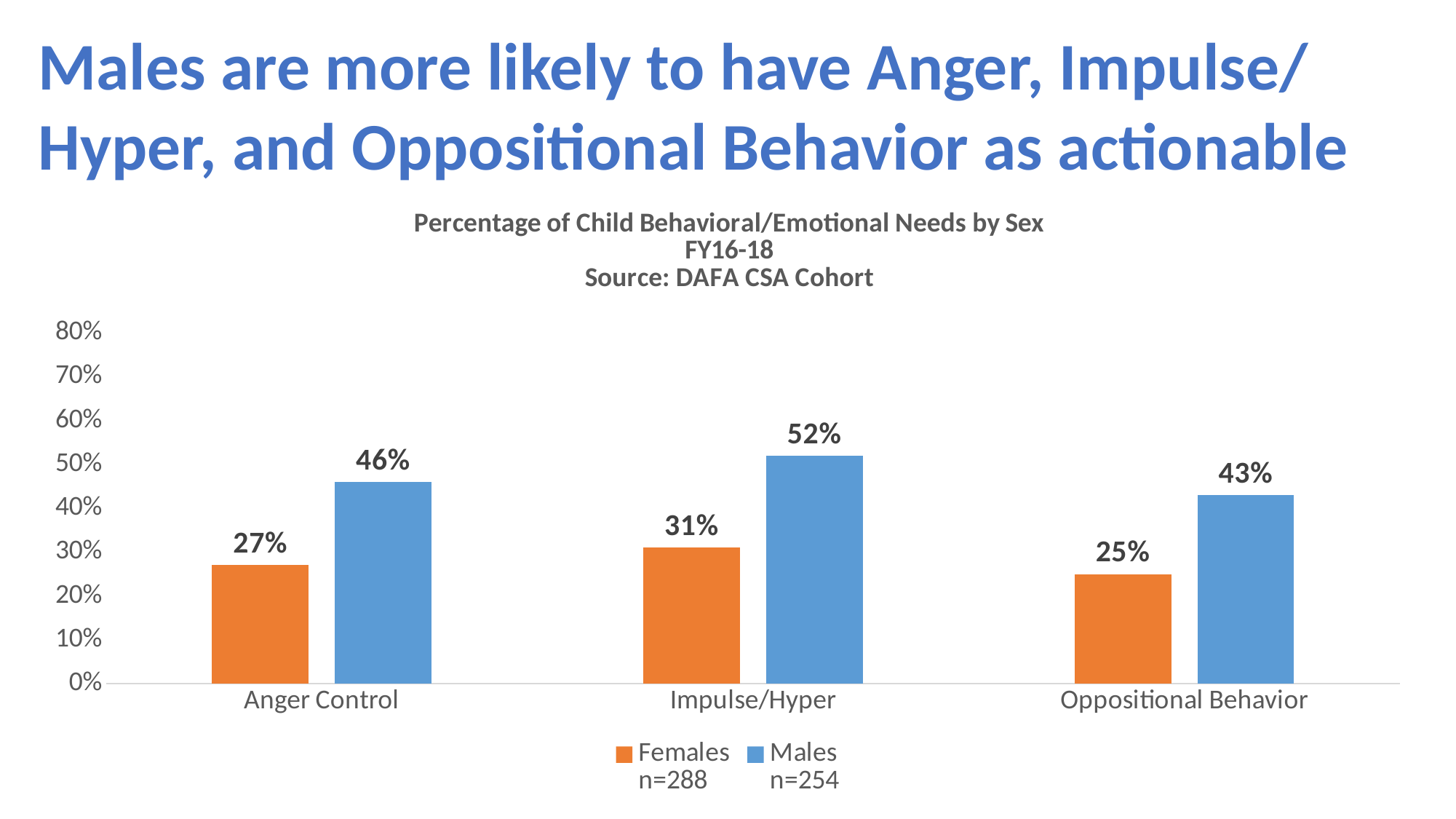
Which is larger: the female value for Impulse/Hyper or the female value for Oppositional Behavior? Impulse/Hyper What is the value for females in the Impulse/Hyper category? 31% What is the value for males in the Oppositional Behavior category? 43% How many categories are shown on the x axis? 3 What is the difference between the male and female values for Anger Control? 19% What is the difference between the male and female values for Impulse/Hyper? 21% What kind of chart is shown on the slide? Bar chart What percentage of females have Anger Control as an actionable need? 27% Which category has the lowest value for females? Oppositional Behavior Which category has the highest value for males? Impulse/Hyper What percentage of males have Impulse/Hyper as an actionable need? 52% How many series does the legend list? 2